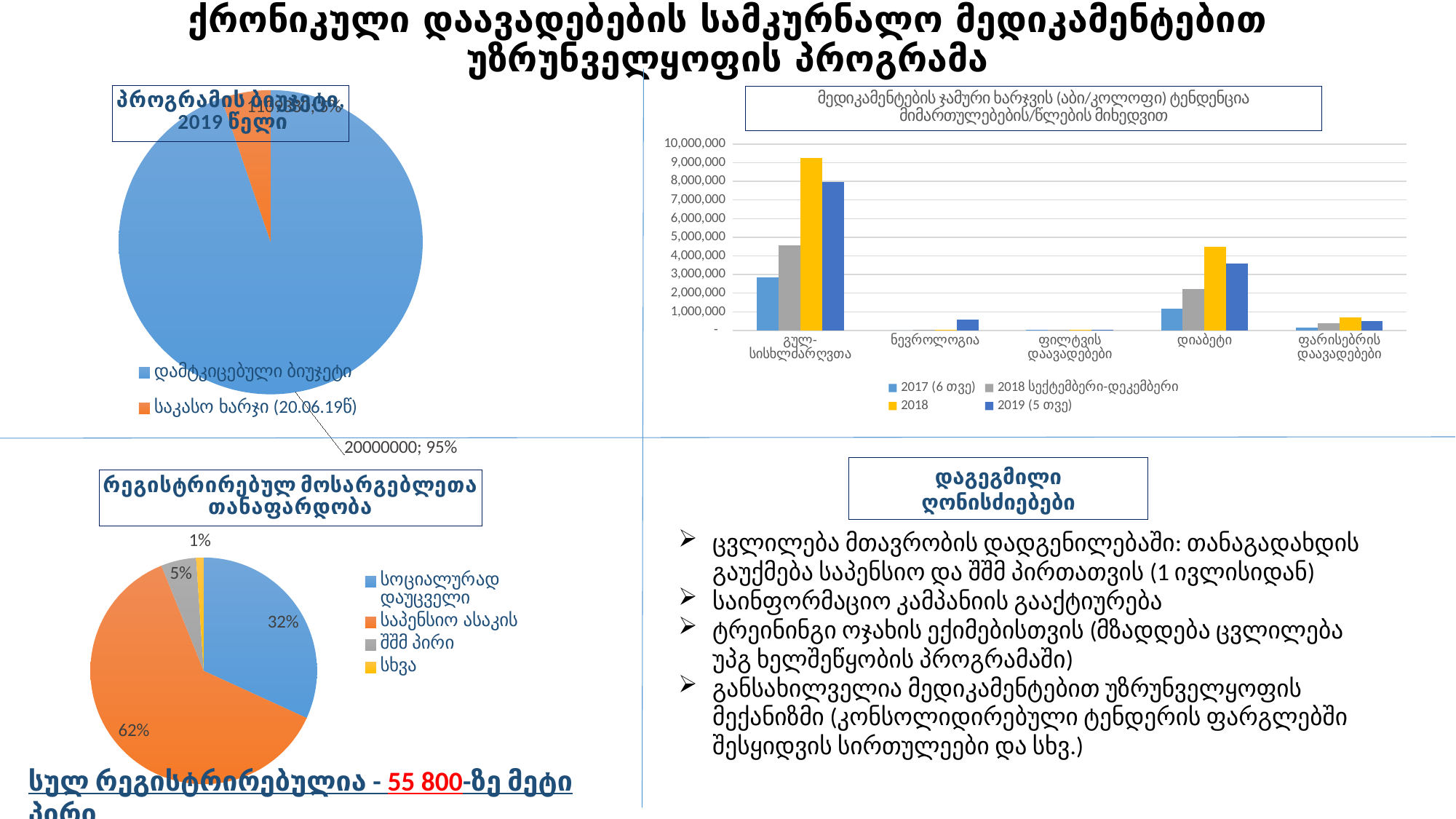
In the bottom-left pie chart (რეგისტრირებულ მოსარგებლეთა თანაფარდობა), which category has the smallest share? სხვა In the bottom-left pie chart (რეგისტრირებულ მოსარგებლეთა თანაფარდობა), how many percentage points larger is საპენსიო ასაკის than სოციალურად დაუცველი? 30 How many categories are shown on the x axis of the top-right bar chart (მედიკამენტების ჯამური ხარჯვის ტენდენცია)? 5 How many categories does the bottom-left pie chart (რეგისტრირებულ მოსარგებლეთა თანაფარდობა) show? 4 In the top-right bar chart (მედიკამენტების ჯამური ხარჯვის ტენდენცია), is the 2018 value for გულ-სისხლძარღვთა greater or less than 9,000,000? greater In the bottom-left pie chart (რეგისტრირებულ მოსარგებლეთა თანაფარდობა), what share is labelled for საპენსიო ასაკის? 62% What kind of chart is the top-right chart (მედიკამენტების ჯამური ხარჯვის ტენდენცია)? bar chart How many series does the legend of the top-right bar chart (მედიკამენტების ჯამური ხარჯვის ტენდენცია) list? 4 In the bottom-left pie chart (რეგისტრირებულ მოსარგებლეთა თანაფარდობა), what share is labelled for სოციალურად დაუცველი? 32% In the bottom-left pie chart (რეგისტრირებულ მოსარგებლეთა თანაფარდობა), which category has the largest share? საპენსიო ასაკის In the top-right bar chart (მედიკამენტების ჯამური ხარჯვის ტენდენცია), which category has the highest 2018 value? გულ-სისხლძარღვთა In the top-left pie chart (პროგრამის ბიუჯეტი 2019 წელი), what share is labelled for დამტკიცებული ბიუჯეტი? 95%